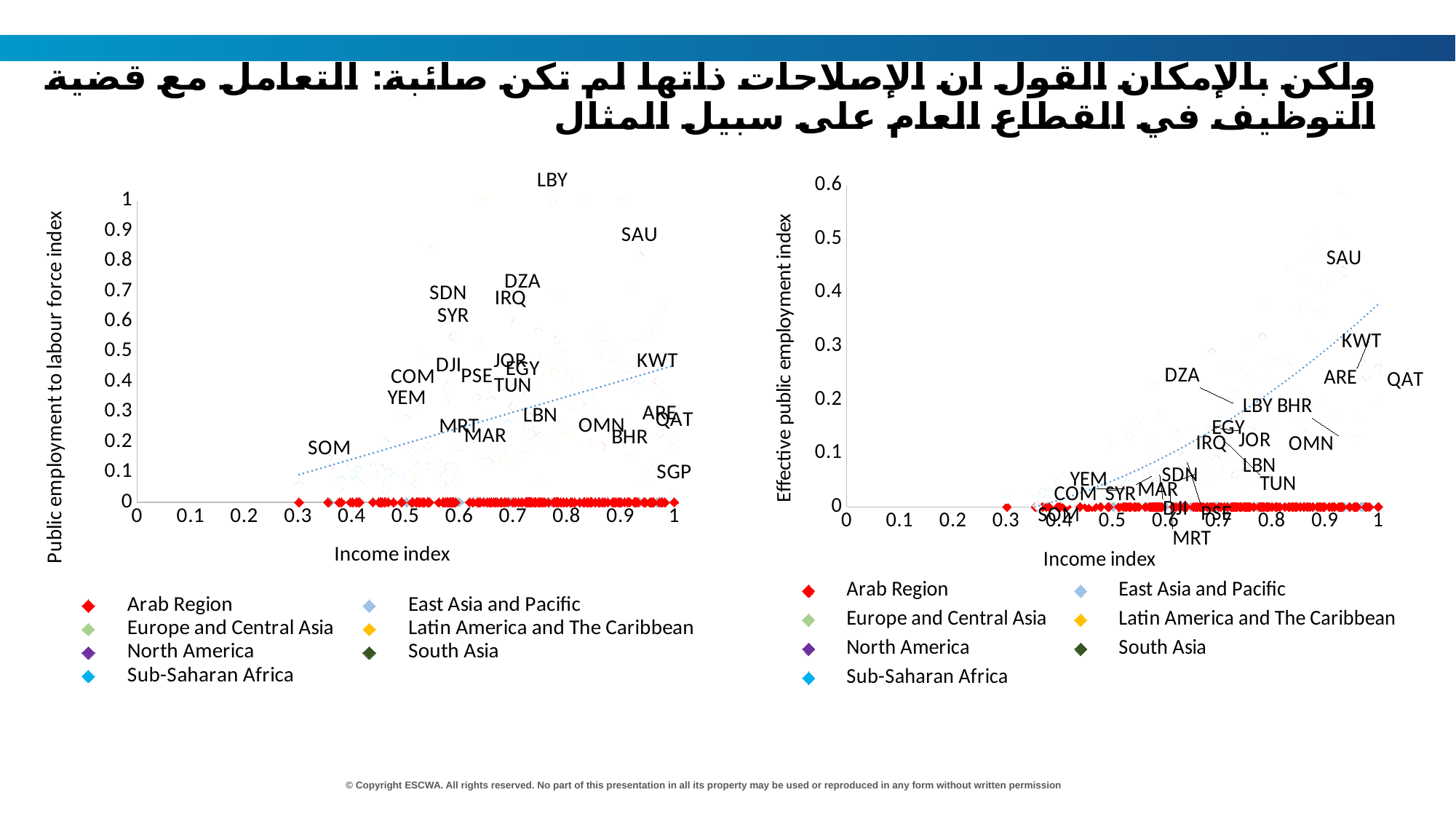
How many series does the legend of the left chart list? 7 How many series does the legend of the right chart list? 7 What kind of chart is the right chart on the slide? Scatter chart In the left chart, is the value for SOM greater or less than 0.5? less In the left chart, is the value for SAU greater or less than 0.5? greater In the right chart, what is the label of the vertical axis? Effective public employment index In the right chart, is the value for SAU greater or less than 0.3? greater What kind of chart is the left chart on the slide? Scatter chart In the left chart, what is the label of the vertical axis? Public employment to labour force index In the right chart, which labelled country has the highest effective public employment index? SAU In the left chart, which labelled country has the highest public employment to labour force index? LBY